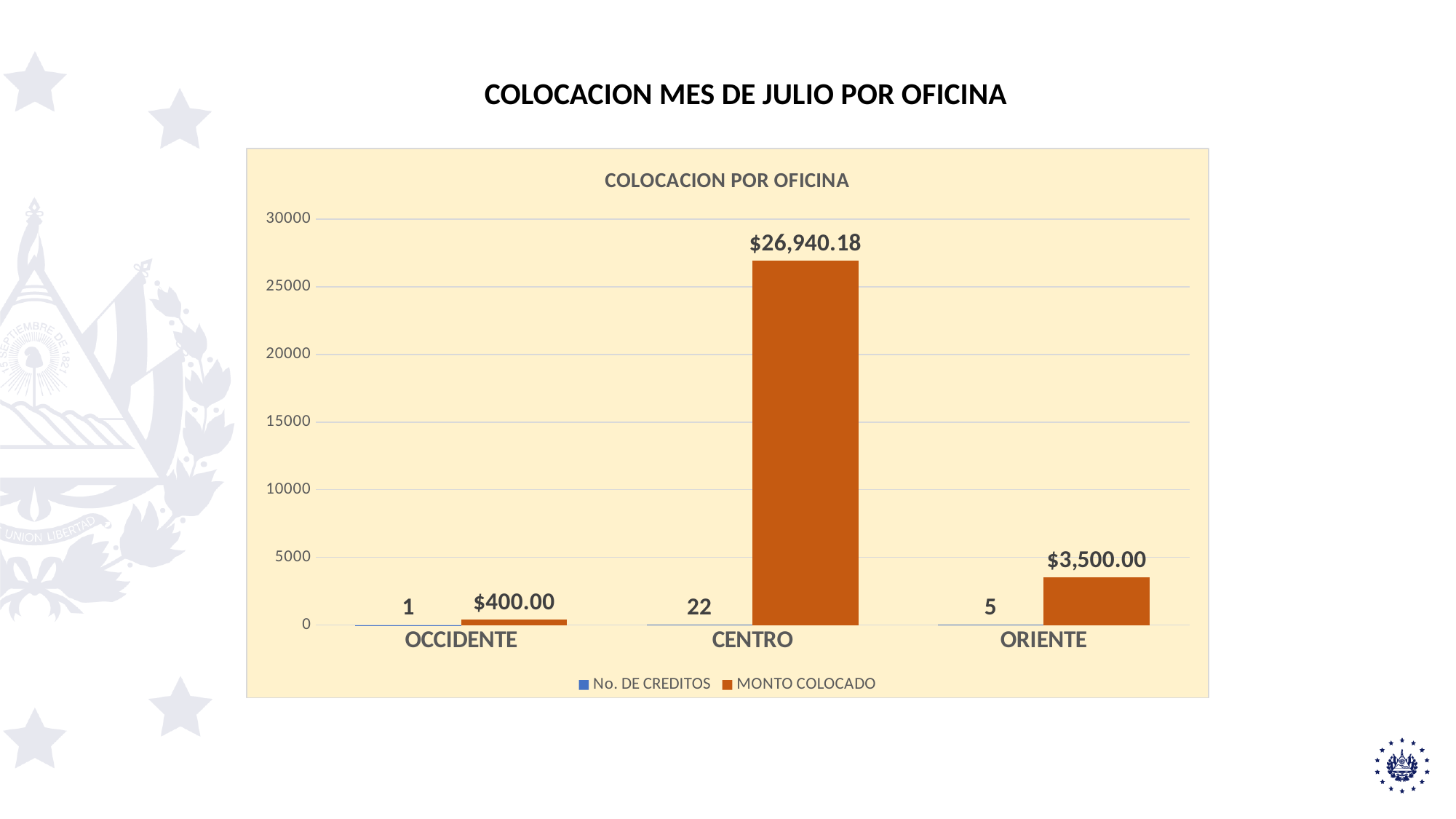
Is the MONTO COLOCADO for CENTRO greater or less than 25000? greater How many series does the legend list? 2 What is the No. DE CREDITOS value for CENTRO? 22 What is the MONTO COLOCADO value for OCCIDENTE? $400.00 What is the MONTO COLOCADO value for CENTRO? $26,940.18 Which office has the highest MONTO COLOCADO? CENTRO How many offices are shown on the x axis? 3 Which office has the lowest No. DE CREDITOS? OCCIDENTE Which is larger, the MONTO COLOCADO for ORIENTE or for OCCIDENTE? ORIENTE What is the difference between the MONTO COLOCADO for ORIENTE and OCCIDENTE? $3,100.00 What kind of chart is shown? bar chart What is the No. DE CREDITOS value for ORIENTE? 5